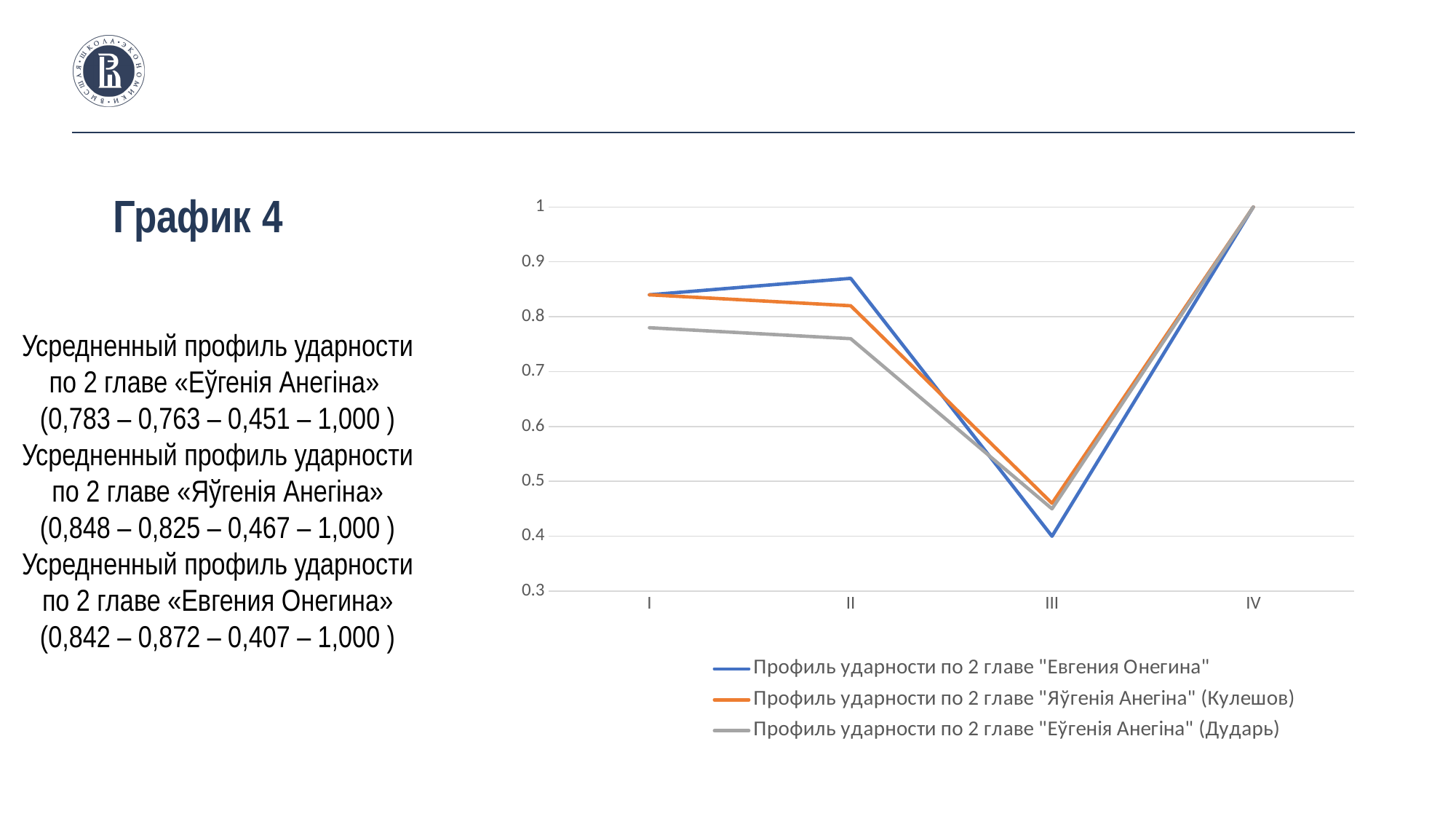
How many series does the legend list? 3 Is the value for "Профиль ударности по 2 главе "Еўгенія Анегіна" (Дударь)" at category I greater or less than 0.8? less What is the value of the series "Профиль ударности по 2 главе "Евгения Онегина"" at category IV? 1 Do the values of all three series rise or fall from category II to category III? fall What kind of chart is shown on the slide? line chart At category II, which series has the larger value: "Профиль ударности по 2 главе "Евгения Онегина"" or "Профиль ударности по 2 главе "Еўгенія Анегіна" (Дударь)"? Профиль ударности по 2 главе "Евгения Онегина" What colour is the line for "Профиль ударности по 2 главе "Евгения Онегина""? blue At which category does the series "Профиль ударности по 2 главе "Еўгенія Анегіна" (Дударь)" reach its highest value? IV At which category does the series "Профиль ударности по 2 главе "Евгения Онегина"" reach its lowest value? III Is the value for "Профиль ударности по 2 главе "Евгения Онегина"" at category II greater or less than 0.8? greater Is the value for "Профиль ударности по 2 главе "Евгения Онегина"" at category III greater or less than 0.5? less How many categories are shown on the x axis? 4